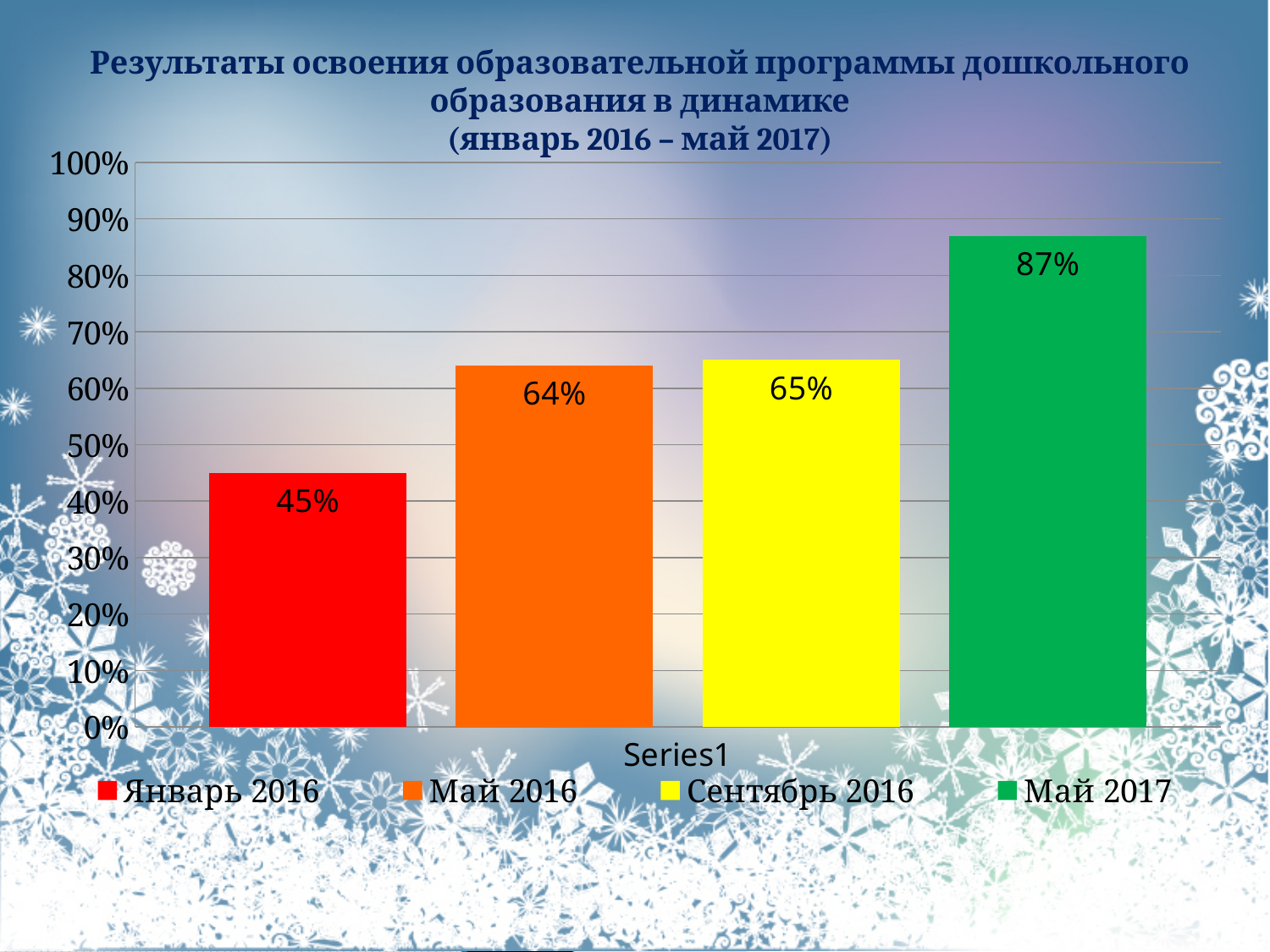
What is the difference between the values for Май 2017 and Январь 2016? 42% What is the value for Сентябрь 2016? 65% Which is larger, the value for Май 2016 or the value for Май 2017? Май 2017 What is the value for Май 2016? 64% Do the values rise or fall from Январь 2016 to Май 2017? Rise Which period has the lowest value? Январь 2016 What is the value for Май 2017? 87% How many series does the legend list? 4 Which period has the highest value? Май 2017 What is the value for Январь 2016? 45% What kind of chart is shown on the slide? Bar chart What is the difference between the values for Сентябрь 2016 and Май 2016? 1%